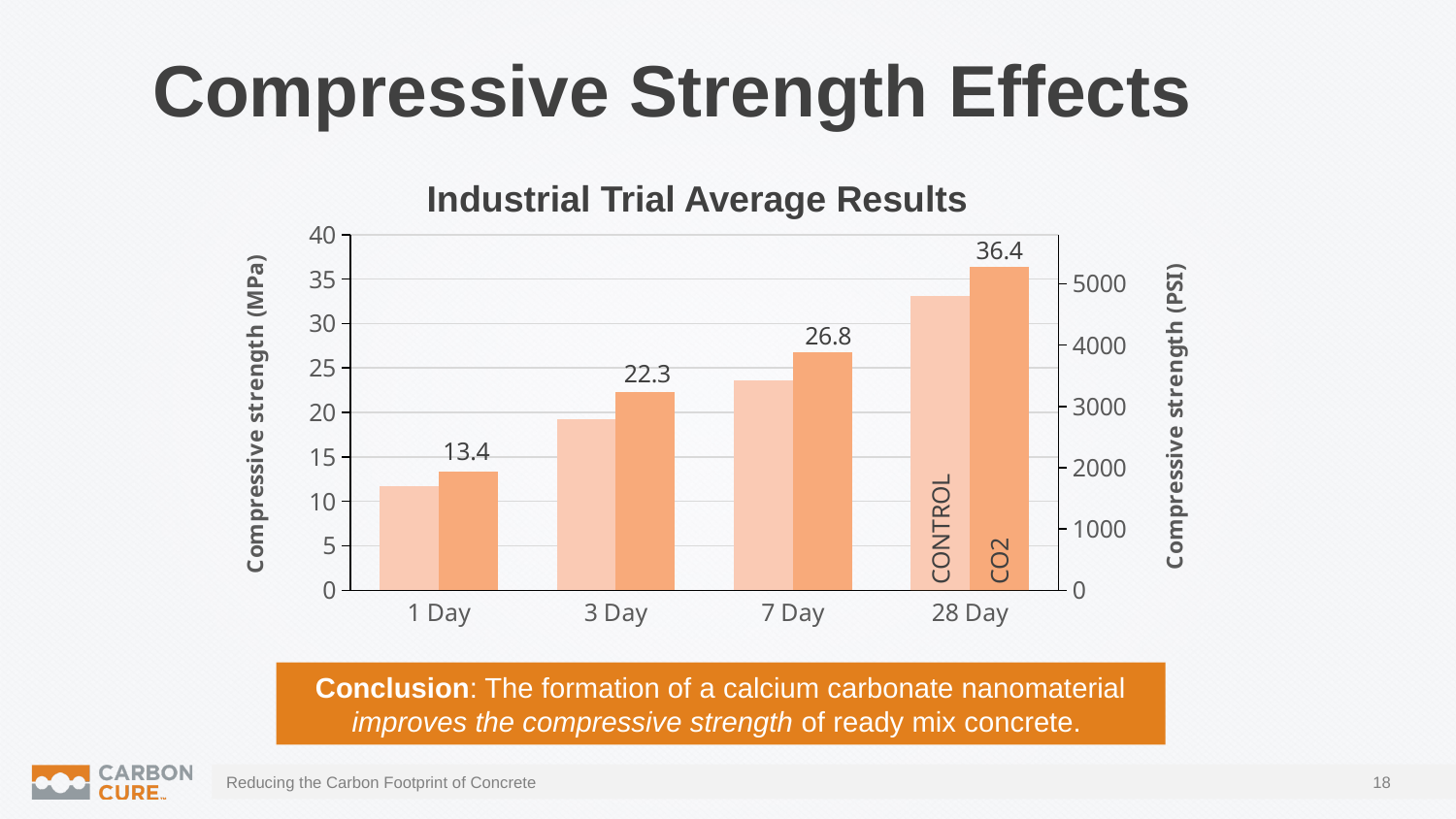
What is the CO2 compressive strength value at 28 Day? 36.4 What is the difference between the CO2 values at 7 Day and 3 Day? 4.5 Is the CONTROL value at 1 Day greater or less than 15 MPa? less What is the CO2 compressive strength value at 7 Day? 26.8 Do the CO2 values rise or fall from 1 Day to 28 Day? rise At which age is the CO2 series value lowest? 1 Day What is the CO2 compressive strength value at 1 Day? 13.4 At 3 Day, which is larger: the CONTROL bar or the CO2 bar? CO2 How many age categories are shown on the x axis? 4 Is the CONTROL value at 28 Day greater or less than 30 MPa? greater What is the difference between the CO2 values at 28 Day and 1 Day? 23.0 At which age does the CO2 series reach its highest value? 28 Day